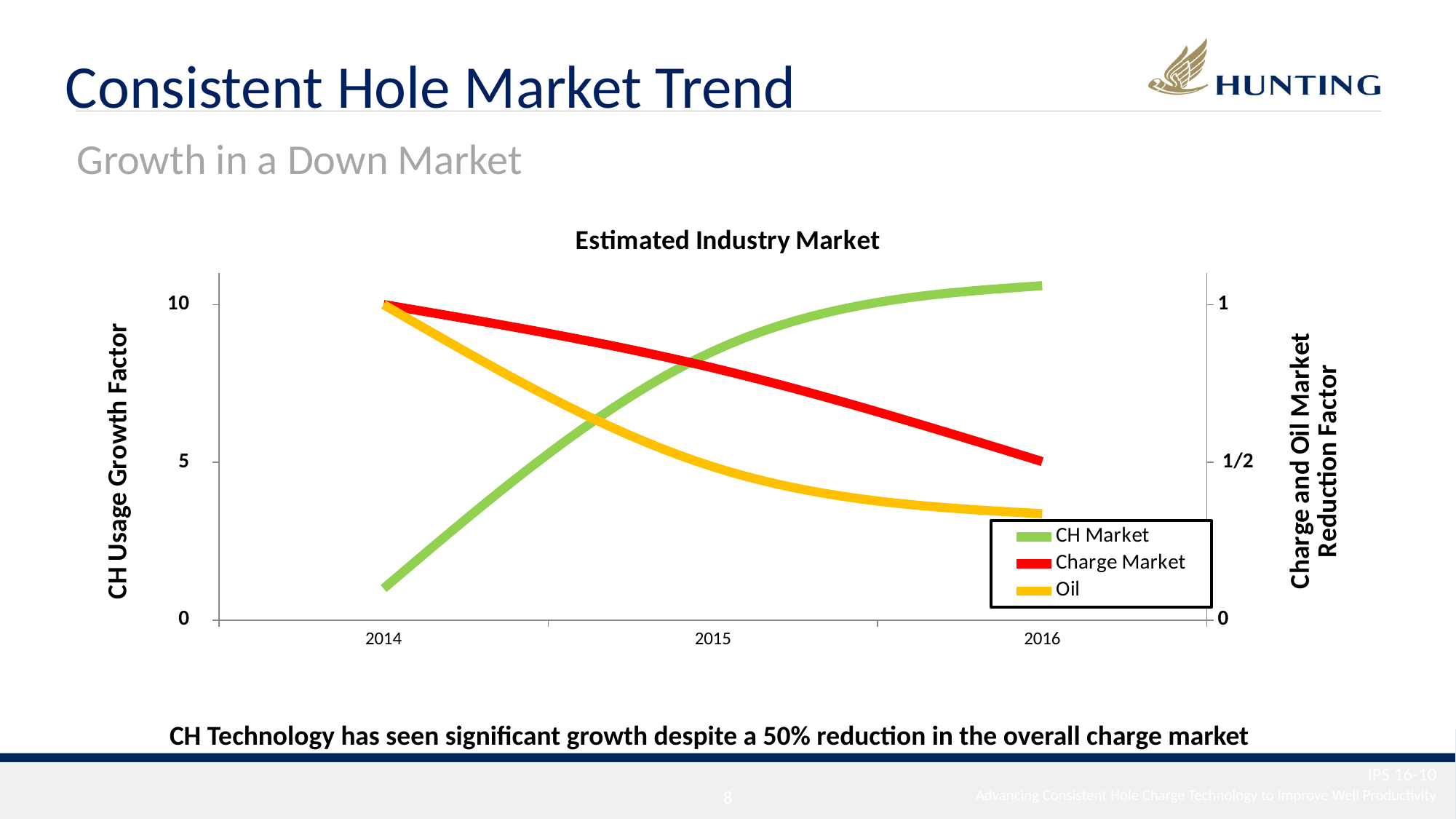
Does the Charge Market line rise or fall from 2014 to 2016? falls Does the CH Market line rise or fall from 2014 to 2016? rises Does the Oil line rise or fall from 2014 to 2016? falls How many series does the legend of the Estimated Industry Market chart list? 3 Is the Oil value in 2016 greater or less than 1/2 on the right axis? less Is the CH Market value in 2014 greater or less than 5 on the left axis? less How many years are shown on the x axis of the chart? 3 In 2016, which is higher on the right axis: Charge Market or Oil? Charge Market What is the Charge Market reduction factor in 2014 on the right axis? 1 What kind of chart is shown on the slide? line chart What is the title of the chart? Estimated Industry Market What is the Charge Market reduction factor in 2016 on the right axis? 1/2